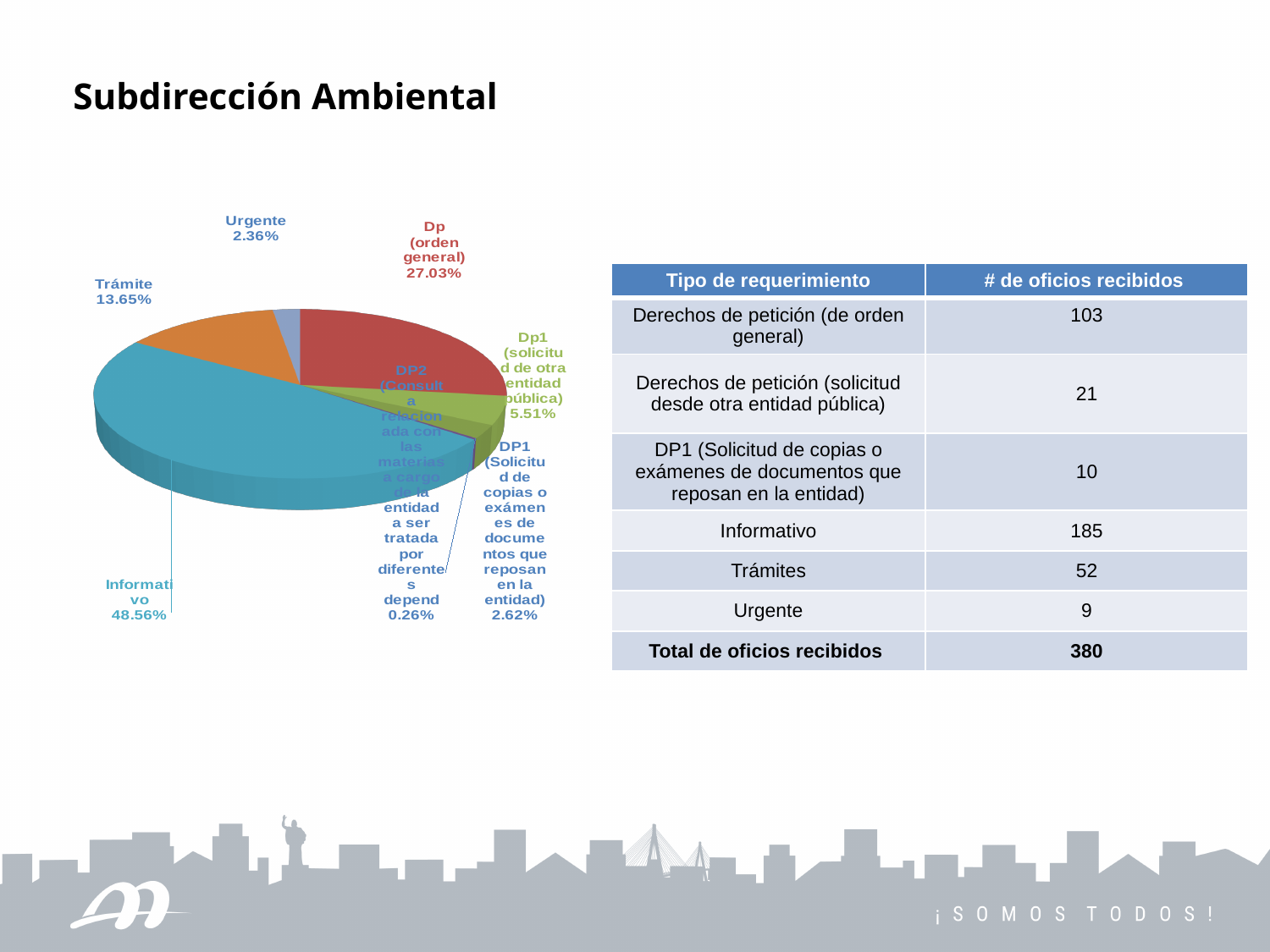
What percentage does the Trámite slice represent in the pie chart? 13.65% What percentage does the Urgente slice represent in the pie chart? 2.36% Which category has the largest slice in the pie chart? Informativo Which category has the smallest slice in the pie chart? DP2 (Consulta relacionada con las materias a cargo de la entidad) What kind of chart is shown on the slide? pie chart What percentage does the Informativo slice represent in the pie chart? 48.56% What percentage is shown for the Dp1 (solicitud de otra entidad pública) slice in the pie chart? 5.51% What is the difference in percentage points between the Informativo slice and the Dp (orden general) slice? 21.53 Which slice is larger in the pie chart, Trámite or Urgente? Trámite What percentage is shown for the Dp (orden general) slice in the pie chart? 27.03% How many slices does the pie chart have? 7 What is the title of the slide containing the pie chart? Subdirección Ambiental